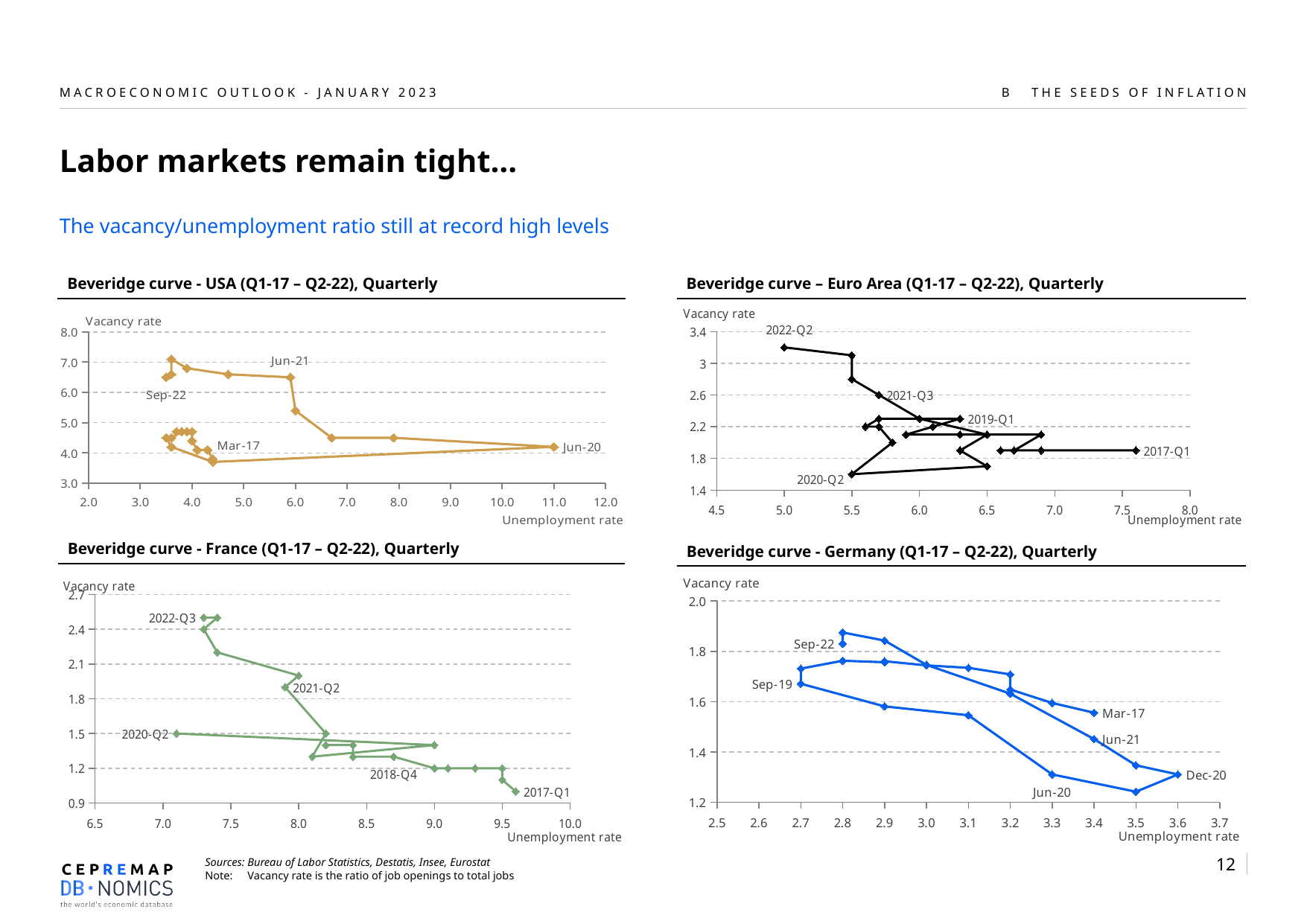
In the Beveridge curve - Germany chart, which point has the higher vacancy rate, Sep-22 or Jun-20? Sep-22 In the Beveridge curve – Euro Area chart, is the vacancy rate at 2022-Q2 greater or less than 3? greater In the Beveridge curve - USA chart, is the vacancy rate at Jun-20 greater or less than 5.0? less In the Beveridge curve - France chart, is the vacancy rate at 2022-Q3 greater or less than 2.1? greater In the Beveridge curve - USA chart, which point has the higher unemployment rate, Jun-21 or Jun-20? Jun-20 What is the label of the horizontal axis on the Beveridge curve - Germany chart? Unemployment rate What kind of chart is the Beveridge curve - USA chart? Line chart (scatter with connected points) What colour is the line in the Beveridge curve - France chart? Green